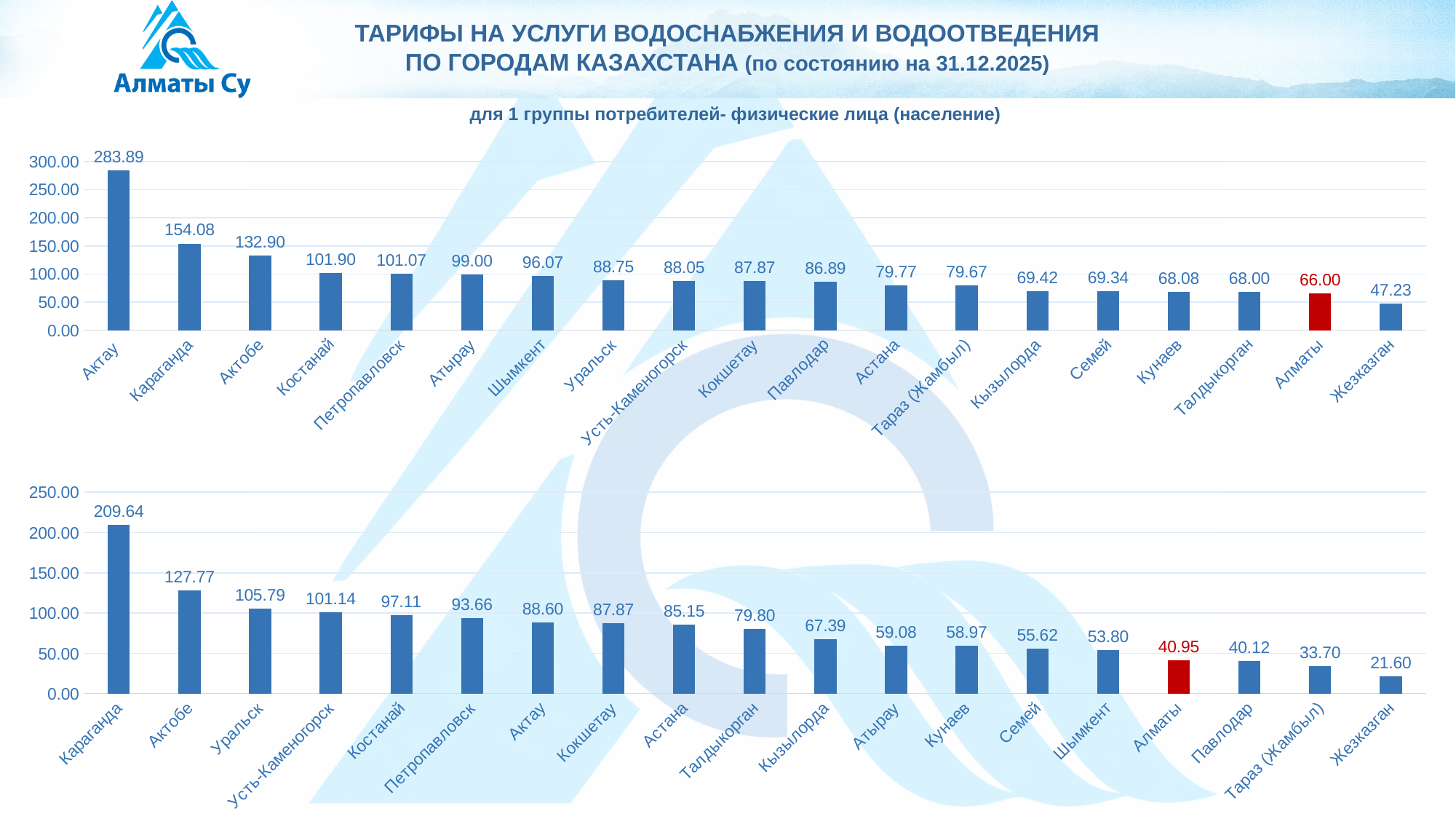
In the bottom chart, what is the value for Алматы? 40.95 In the bottom chart, what is the difference between the values for Алматы and Жезказган? 19.35 In the bottom chart, which city has the highest value? Караганда In the top chart, which city has the lowest value? Жезказган In the bottom chart, what is the value for Караганда? 209.64 In the top chart, what is the value for Алматы? 66.00 What type of chart is the bottom chart? Bar chart In the top chart, which city's bar is coloured red? Алматы In the bottom chart, which is larger: the value for Актобе or the value for Уральск? Актобе In the top chart, what is the difference between the values for Актау and Караганда? 129.81 How many cities are shown in the top chart? 19 In the top chart, what is the value for Актау? 283.89